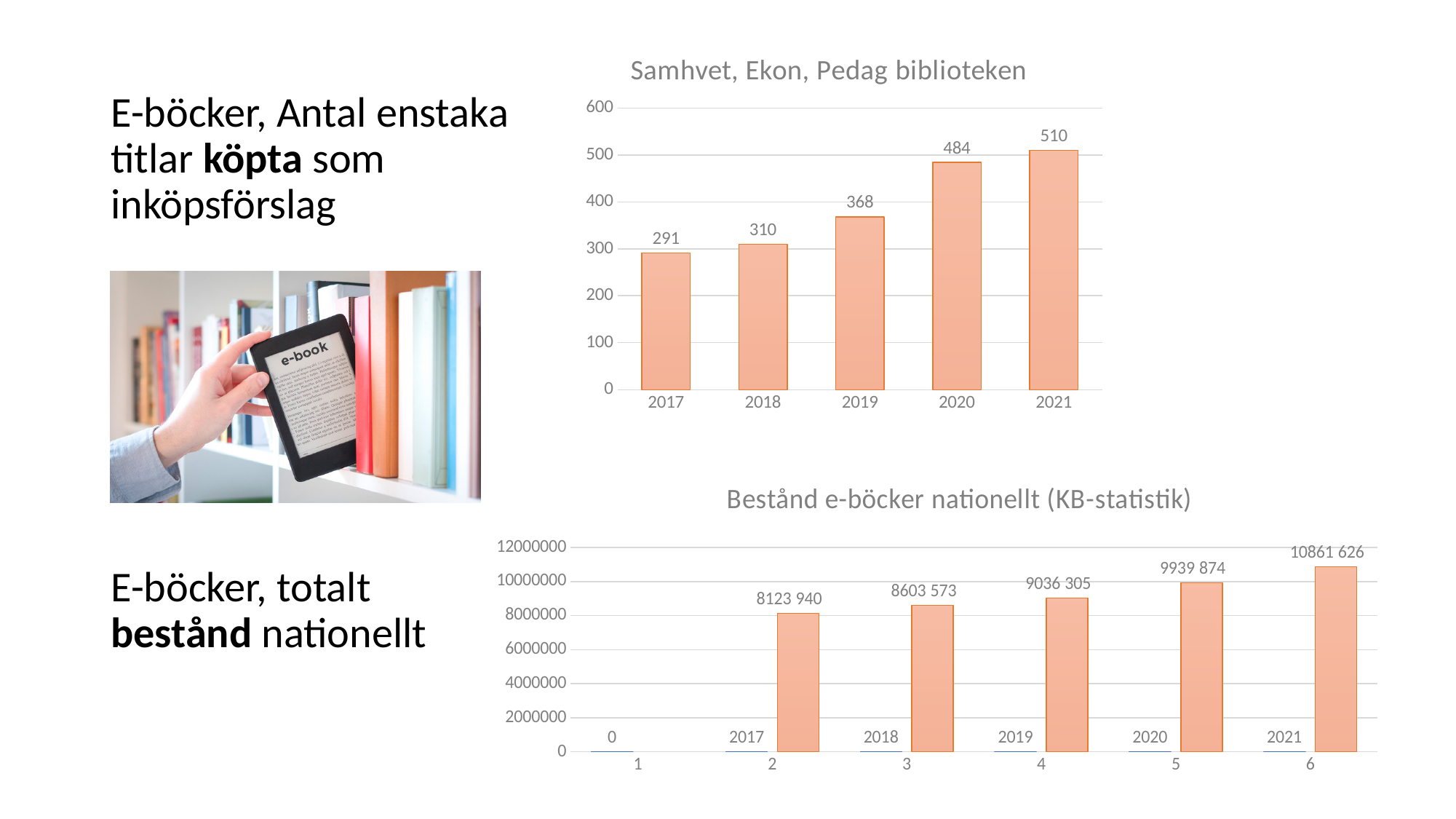
In the chart titled 'Bestånd e-böcker nationellt (KB-statistik)', what is the value of the orange bar at category 2 (next to the 2017 label)? 8123 940 In the chart titled 'Samhvet, Ekon, Pedag biblioteken', which year has the lowest value? 2017 In the chart titled 'Bestånd e-böcker nationellt (KB-statistik)', is the orange bar at category 3 (next to the 2018 label) greater or less than 8000000? greater In the chart titled 'Samhvet, Ekon, Pedag biblioteken', what is the value for 2021? 510 In the chart titled 'Bestånd e-böcker nationellt (KB-statistik)', what is the value of the orange bar at category 6 (next to the 2021 label)? 10861 626 In the chart titled 'Samhvet, Ekon, Pedag biblioteken', how many years are shown on the x axis? 5 What kind of chart is the top chart, 'Samhvet, Ekon, Pedag biblioteken'? bar chart In the chart titled 'Samhvet, Ekon, Pedag biblioteken', which year has the highest value? 2021 In the chart titled 'Bestånd e-böcker nationellt (KB-statistik)', which is larger: the orange bar at category 4 (next to the 2019 label) or the orange bar at category 5 (next to the 2020 label)? category 5 (2020) In the chart titled 'Samhvet, Ekon, Pedag biblioteken', what is the difference between the values for 2020 and 2019? 116 In the chart titled 'Samhvet, Ekon, Pedag biblioteken', do the values rise or fall from 2017 to 2021? rise In the chart titled 'Samhvet, Ekon, Pedag biblioteken', what is the value for 2019? 368